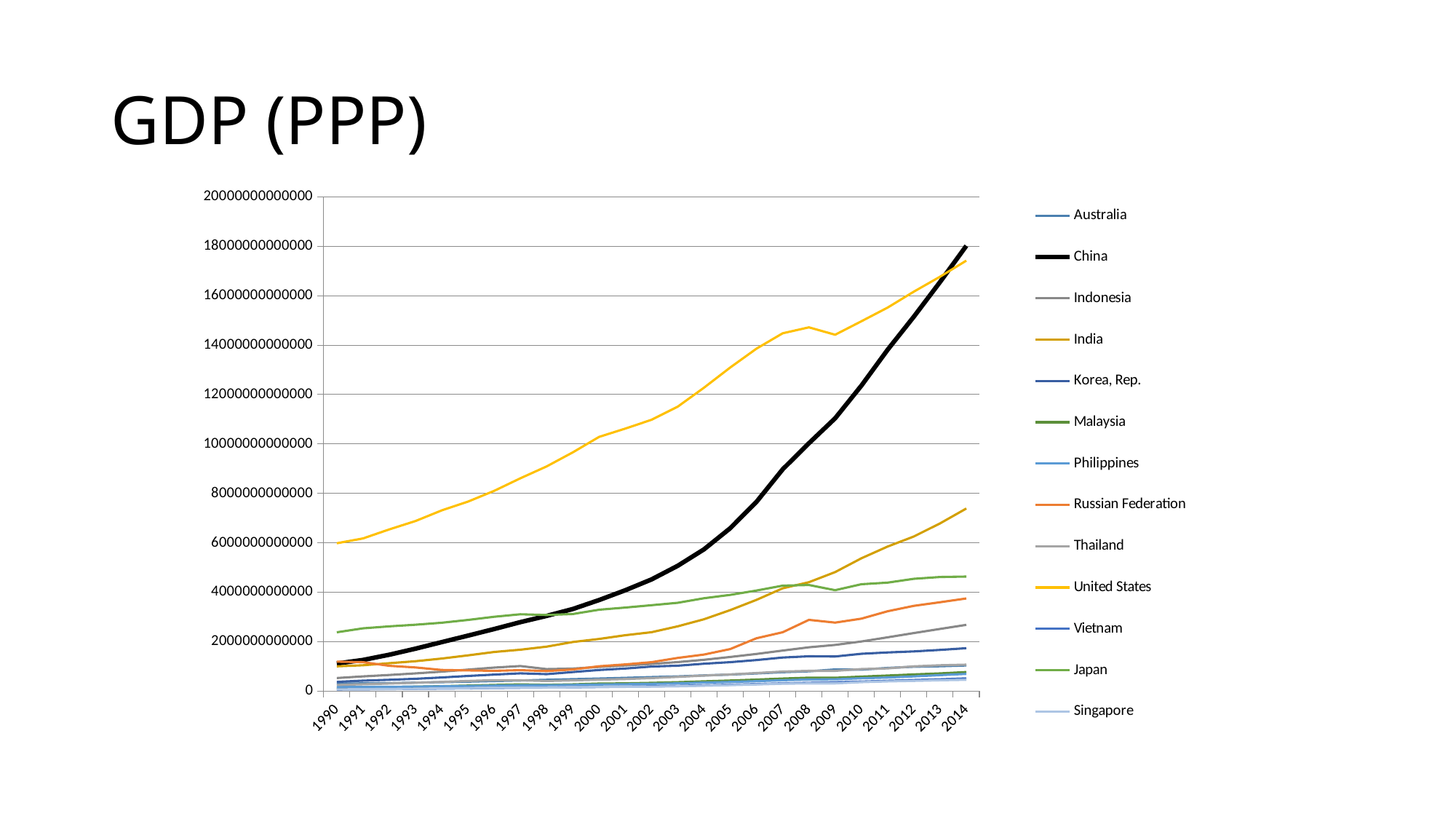
Is the value for the United States in 2014 greater or less than 160000000000000? greater In 2014, which is larger: the value for India or the value for Japan? India Is the value for India in 2014 greater or less than 60000000000000? greater How many series does the legend list? 13 How many years are shown along the x axis? 25 What is the title of the chart? GDP (PPP) In 2010, which is larger: the value for the United States or the value for China? United States What kind of chart is shown on the slide? line chart Does the value for China rise or fall from 1990 to 2014? rise Which series has the highest value in 1990? United States Which series has the highest value in 2014? China Is the value for China in 2000 greater or less than 40000000000000? less